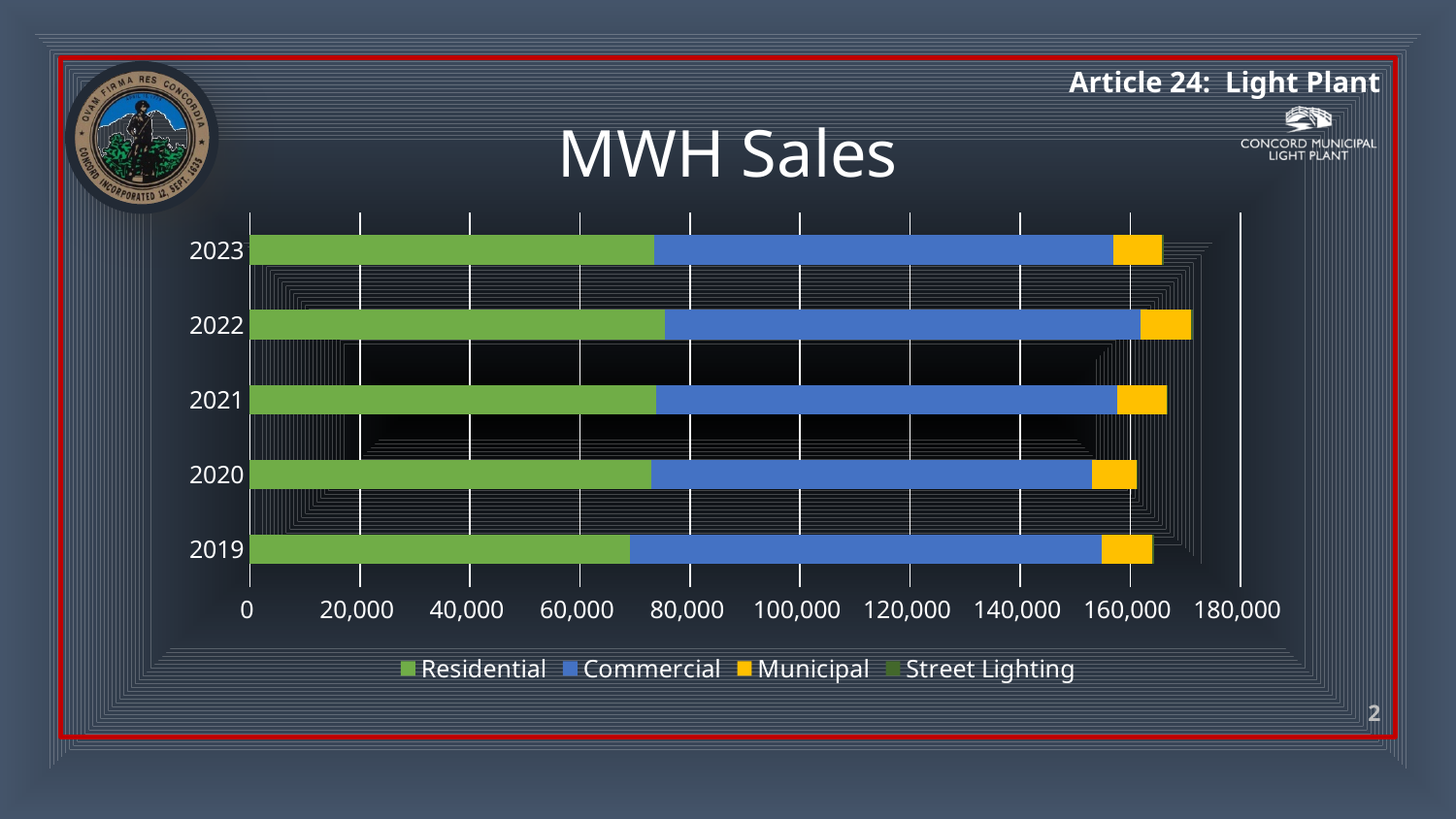
Is the total bar for 2020 greater or less than 180,000? less Which is larger, the total bar for 2022 or the total bar for 2020? 2022 Which is larger, the Residential segment for 2022 or for 2019? 2022 Is the total bar for 2022 greater or less than 160,000? greater Which year has the longest total bar? 2022 How many series does the legend list? 4 What kind of chart is shown on the slide? Stacked bar chart Which colour represents the Commercial series in the legend? Blue Is the Residential segment for 2019 greater or less than 80,000? less How many years are shown on the chart? 5 What is the title of the chart? MWH Sales